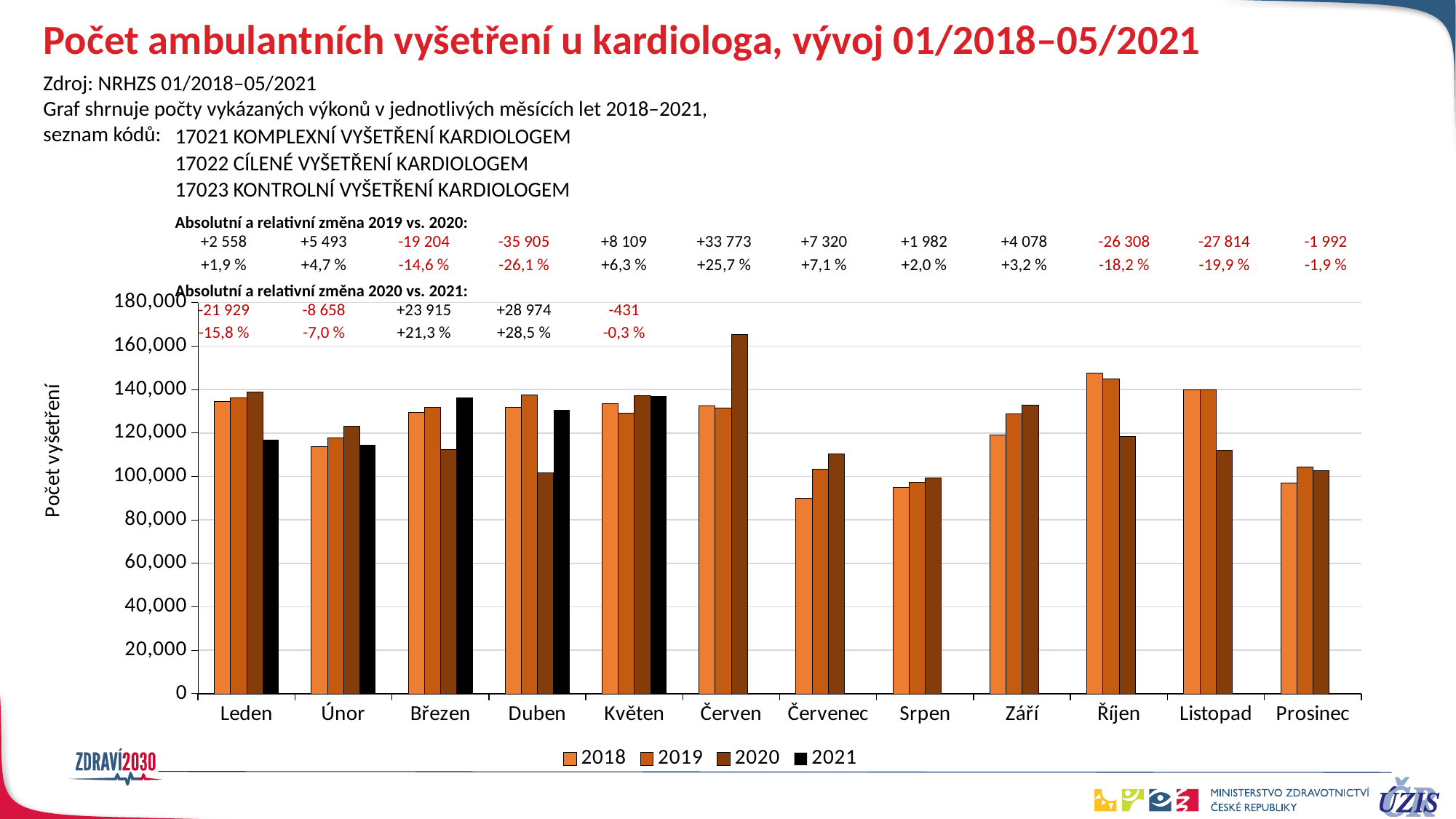
Is the 2020 value for Listopad greater or less than 120,000? less For Duben, which is larger: the 2019 value or the 2020 value? 2019 How many series does the chart legend list? 4 How many months (categories) are shown on the x axis of the chart? 12 Is the 2018 value for Červenec greater or less than 100,000? less Is the 2020 value for Červen greater or less than 160,000? greater Do the 2018 values rise or fall from Srpen to Říjen? rise According to the annotation above the chart, what is the absolute change 2019 vs. 2020 for Červen? +33 773 According to the annotation above the chart, what is the relative change 2020 vs. 2021 for Duben? +28,5 % What kind of chart is shown on the slide? bar chart Which month has the highest value for the 2020 series? Červen Which month has the lowest value for the 2018 series? Červenec